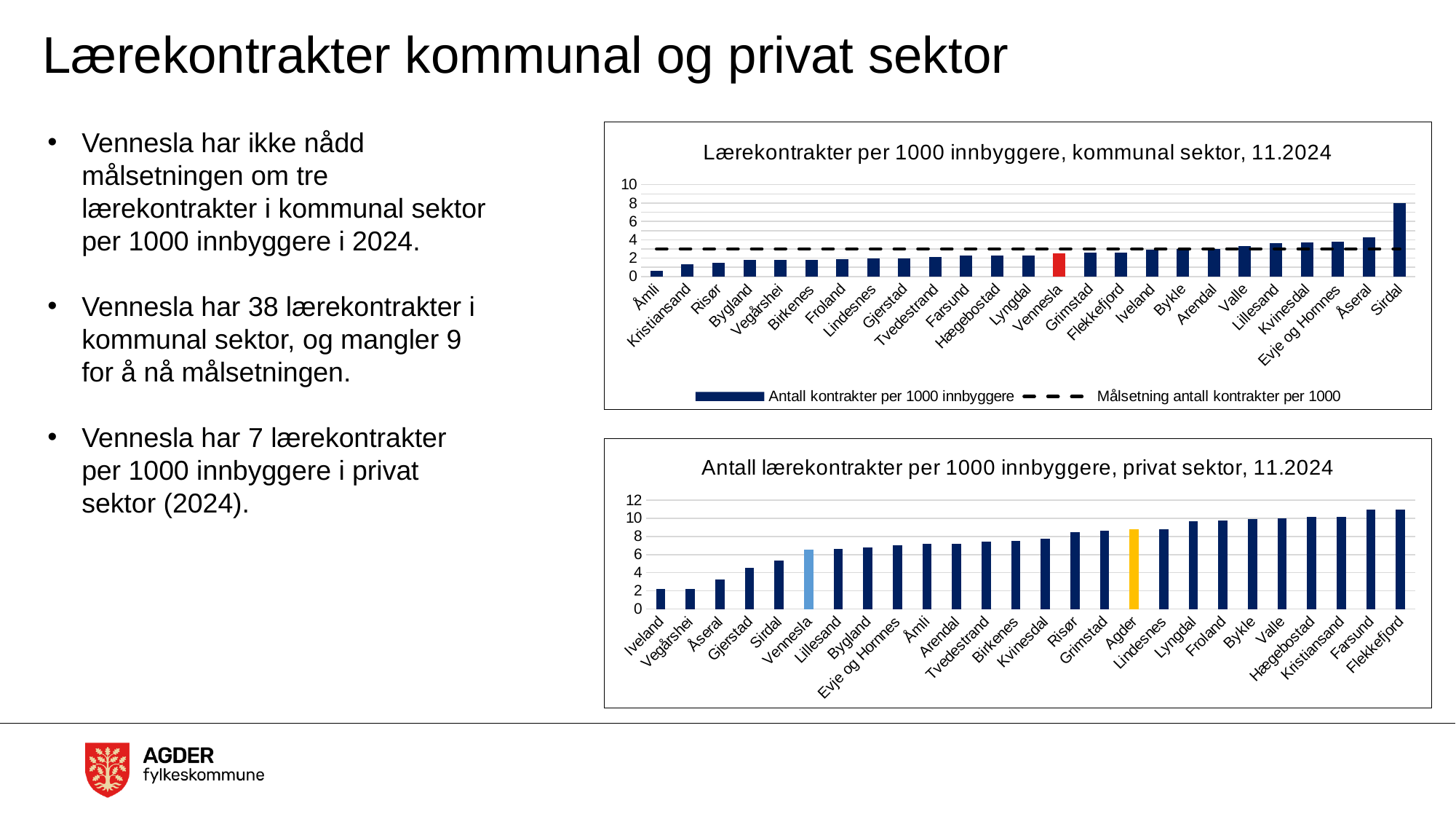
In the top chart (kommunal sektor), do the values rise or fall from left to right along the x axis? rise In the top chart (kommunal sektor), how many series does the legend list? 2 In the bottom chart (privat sektor), which is larger, the value for Flekkefjord or the value for Gjerstad? Flekkefjord In the top chart (kommunal sektor), is the value for Vennesla greater or less than 4? less In the top chart (kommunal sektor), how many municipalities are shown on the x axis? 25 In the top chart (kommunal sektor), what does the dashed line represent according to the legend? Målsetning antall kontrakter per 1000 In the top chart (kommunal sektor), which municipality has the lowest value? Åmli In the bottom chart (privat sektor), is the value for Iveland greater or less than 4? less What type of chart is the top chart, 'Lærekontrakter per 1000 innbyggere, kommunal sektor, 11.2024'? bar chart In the top chart (kommunal sektor), which municipality has the highest value? Sirdal In the bottom chart (privat sektor), how many municipalities/categories are shown on the x axis? 26 In the top chart (kommunal sektor), is the value for Sirdal greater or less than 6? greater